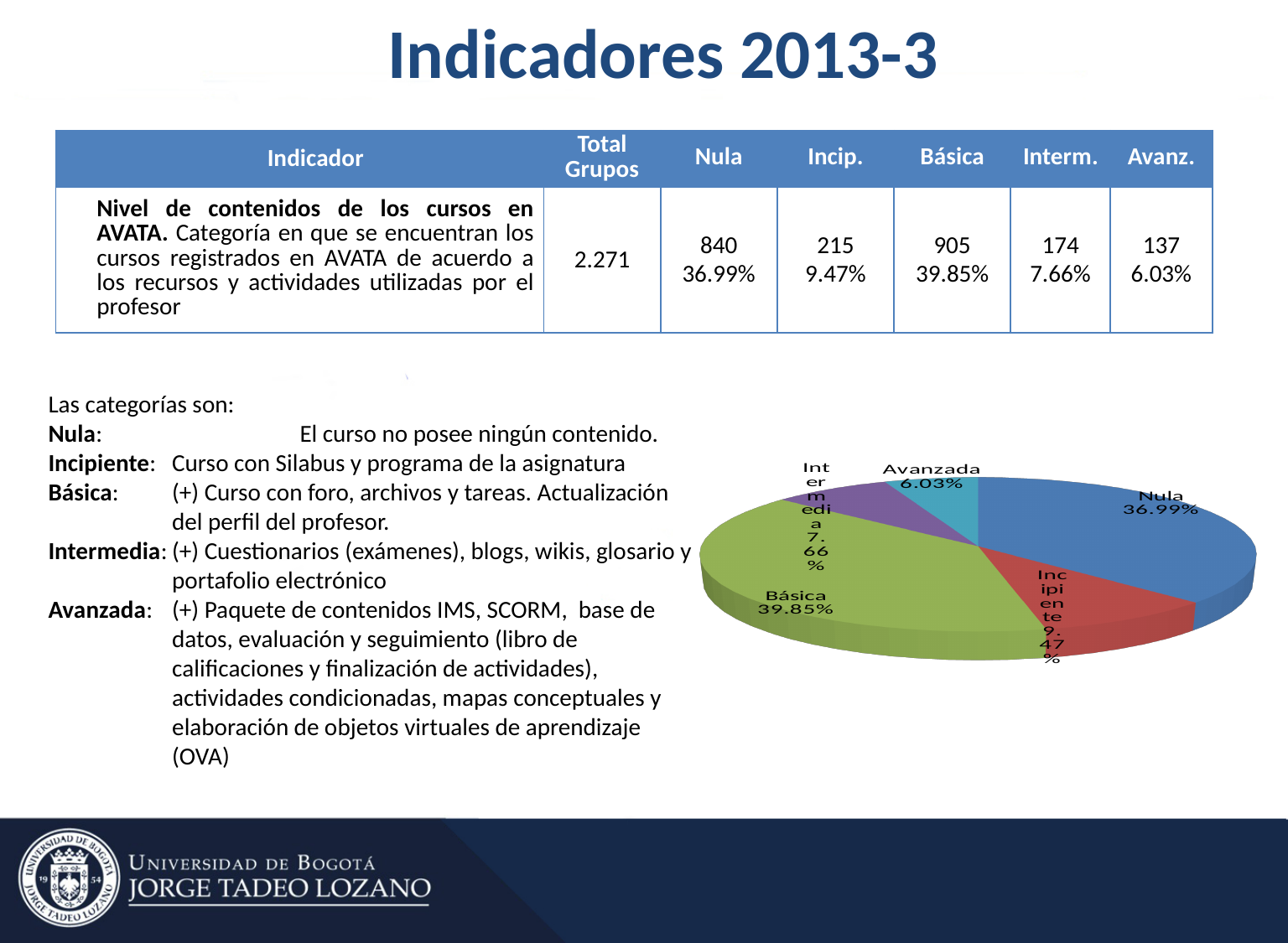
What share of the pie does the Avanzada slice represent? 6.03% What kind of chart is shown on the slide? pie chart Which slice is larger in the pie chart, Nula or Incipiente? Nula What is the difference in percentage points between the Básica and Nula slices? 2.86 How many slices does the pie chart have? 5 Which slice of the pie chart is the largest? Básica What share of the pie does the Intermedia slice represent? 7.66% Which slice of the pie chart is the smallest? Avanzada What share of the pie does the Básica slice represent? 39.85% What colour is the Básica slice in the pie chart? green